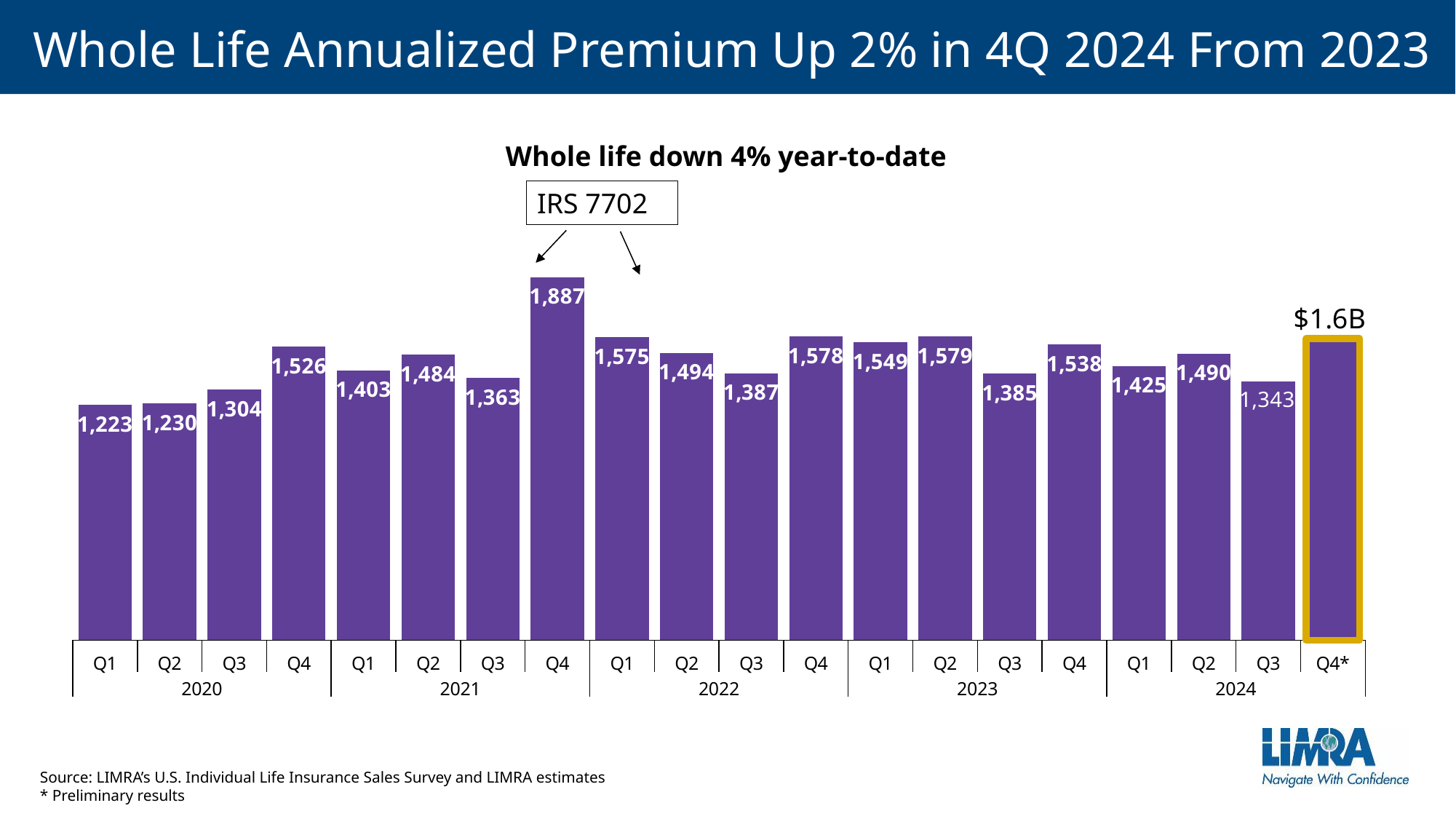
Which quarter has the lowest value? Q1 2020 What is the difference between Q4 2021 and Q1 2022? 312 What kind of chart is shown? Bar chart What text is in the box above the Q4 2021 bar? IRS 7702 How many bars are plotted in the chart? 20 Which is larger, Q4 2020 or Q4 2023? Q4 2023 What is the difference between Q2 2024 and Q1 2024? 65 What is the value for Q1 2020? 1,223 What is the value for Q3 2024? 1,343 What is the value for Q4 2021? 1,887 Which quarter has the highest value? Q4 2021 What is the value labelled on the Q4* 2024 bar? $1.6B